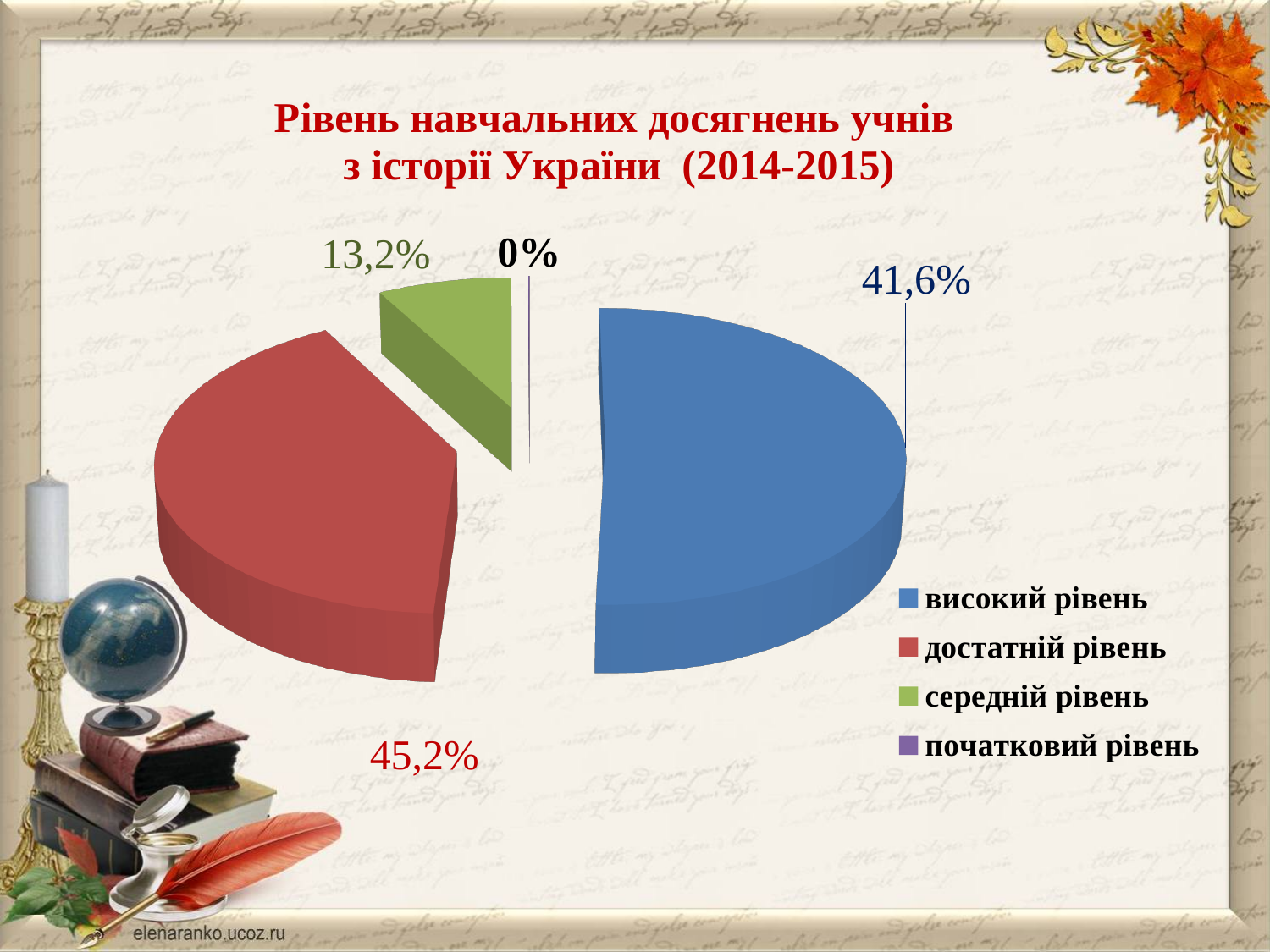
What colour is the slice for середній рівень? green What is the title of the chart? Рівень навчальних досягнень учнів з історії України (2014-2015) Which level has the largest share of the pie? достатній рівень How many categories does the legend list? 4 What is the value for середній рівень? 13,2% What is the value for достатній рівень? 45,2% What is the value for початковий рівень? 0% What is the value for високий рівень? 41,6% What kind of chart is shown on the slide? pie chart Which level has the smallest share of the pie? початковий рівень Which is larger, the share of високий рівень or the share of середній рівень? високий рівень What is the difference between the shares of достатній рівень and високий рівень? 3,6%